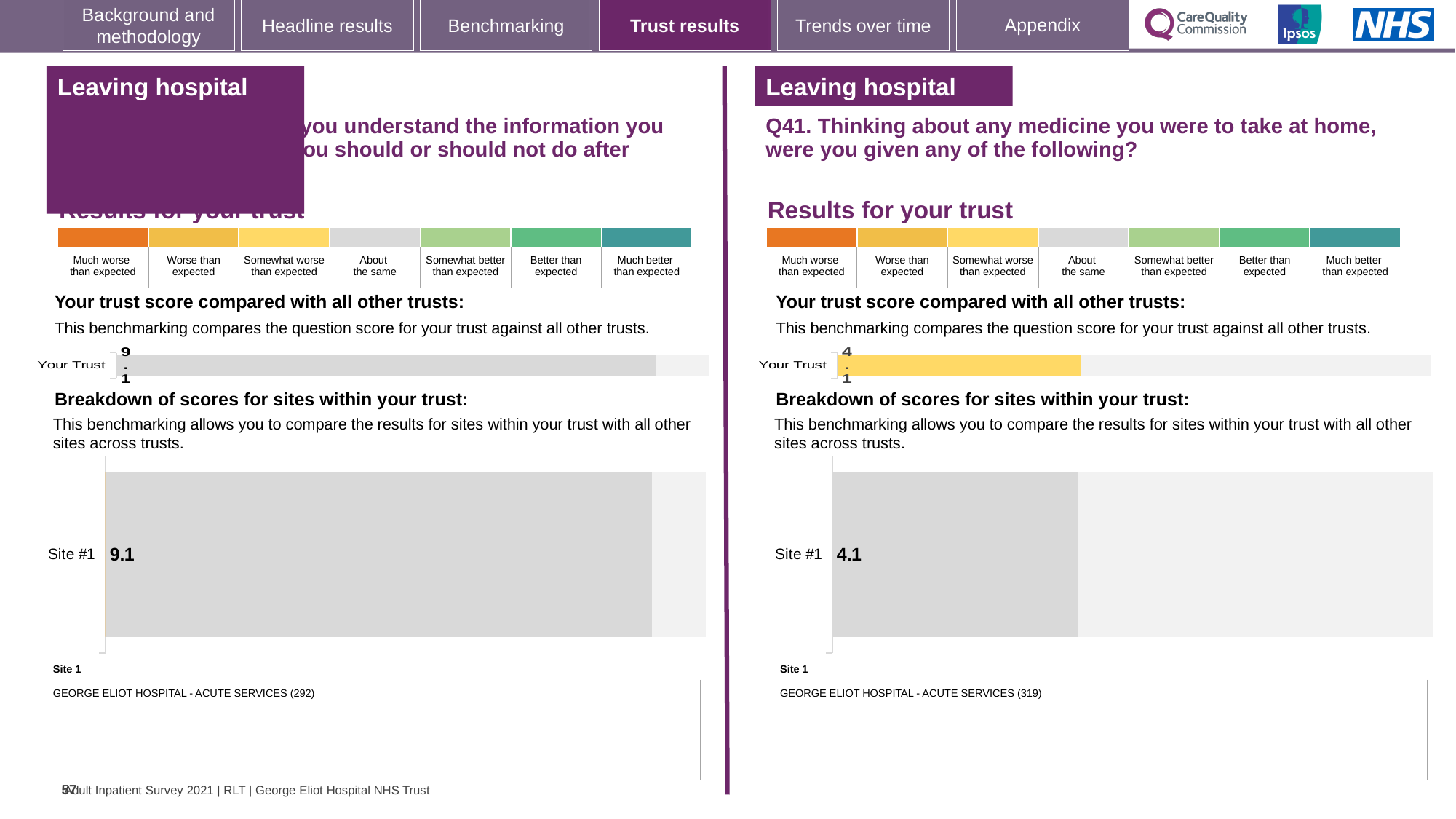
On the right-hand panel (Q41), what is the score shown for Your Trust? 4.1 On the right-hand panel (Q41), what is the score shown for Site #1? 4.1 What kind of chart is used to show the Site #1 score on the right-hand panel (Q41)? bar chart On the left-hand panel, is the Site #1 score greater or less than the Your Trust score on the right-hand panel (Q41)? greater On the right-hand panel (Q41), how many sites are shown in the breakdown of scores chart? 1 On the left-hand panel, what is the score shown for Site #1? 9.1 On the left-hand panel, how many sites are shown in the breakdown of scores chart? 1 On the right-hand panel (Q41), what colour is the Your Trust bar? yellow What is the difference between the Site #1 score on the left-hand panel and the Site #1 score on the right-hand panel (Q41)? 5.0 On the left-hand panel, what is the score shown for Your Trust? 9.1 Which is larger: the Your Trust score on the left-hand panel or the Your Trust score on the right-hand panel (Q41)? left-hand panel On the right-hand panel (Q41), which site name is listed as Site 1? GEORGE ELIOT HOSPITAL - ACUTE SERVICES (319)